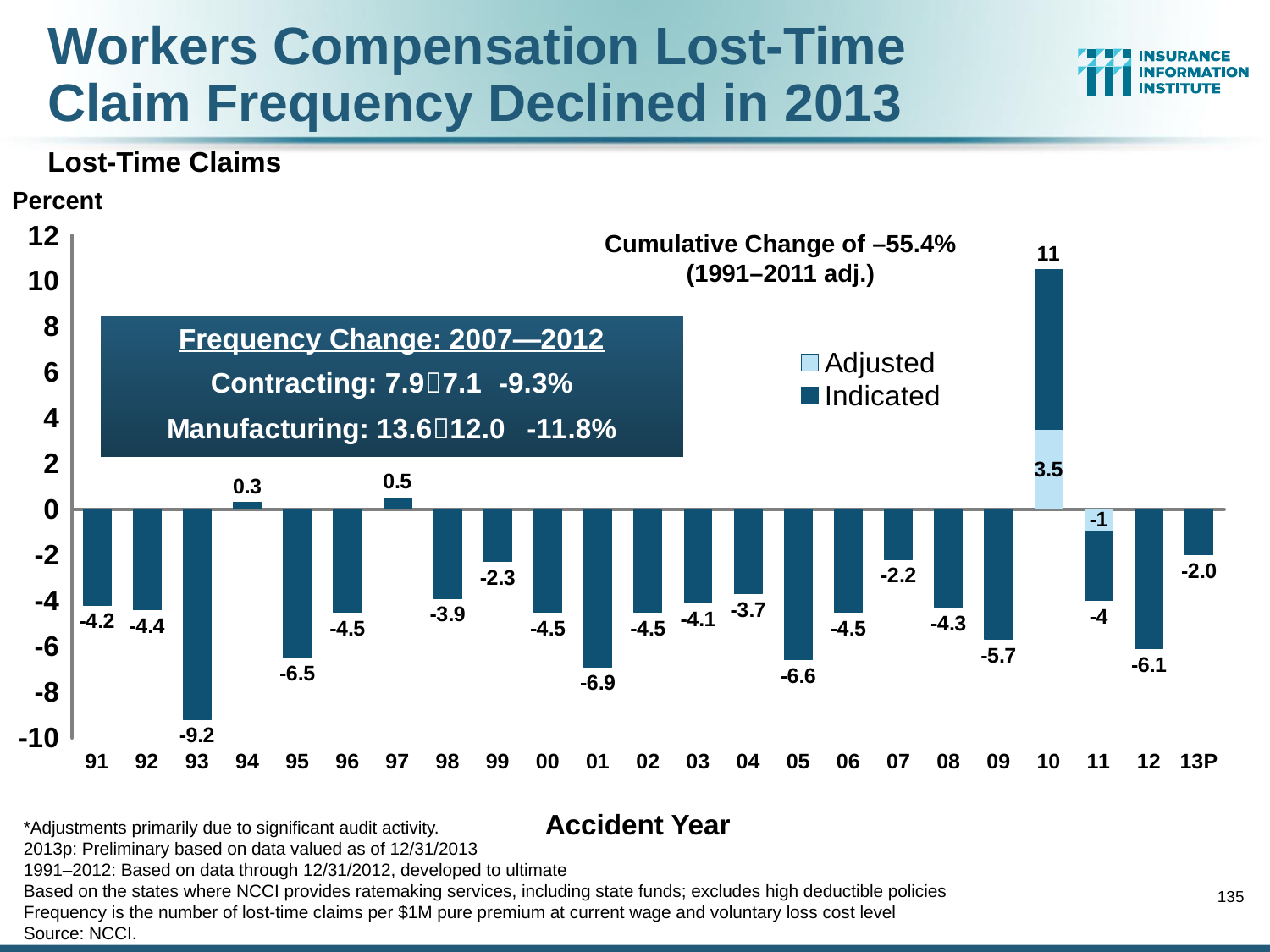
What is the value for accident year 93? -9.2 How many accident years are shown on the x axis? 23 What is the value for accident year 13P? -2.0 Which is lower, the value for accident year 93 or accident year 01? 93 What is the difference between the values for accident years 12 and 13P? 4.1 What cumulative change (1991–2011 adj.) is stated on the chart? –55.4% What is the Indicated value for accident year 10? 11 Which accident year has the lowest value? 93 What kind of chart is shown? Bar chart What is the Adjusted value for accident year 10? 3.5 How many series does the legend list? 2 Which accident year has the highest value? 10